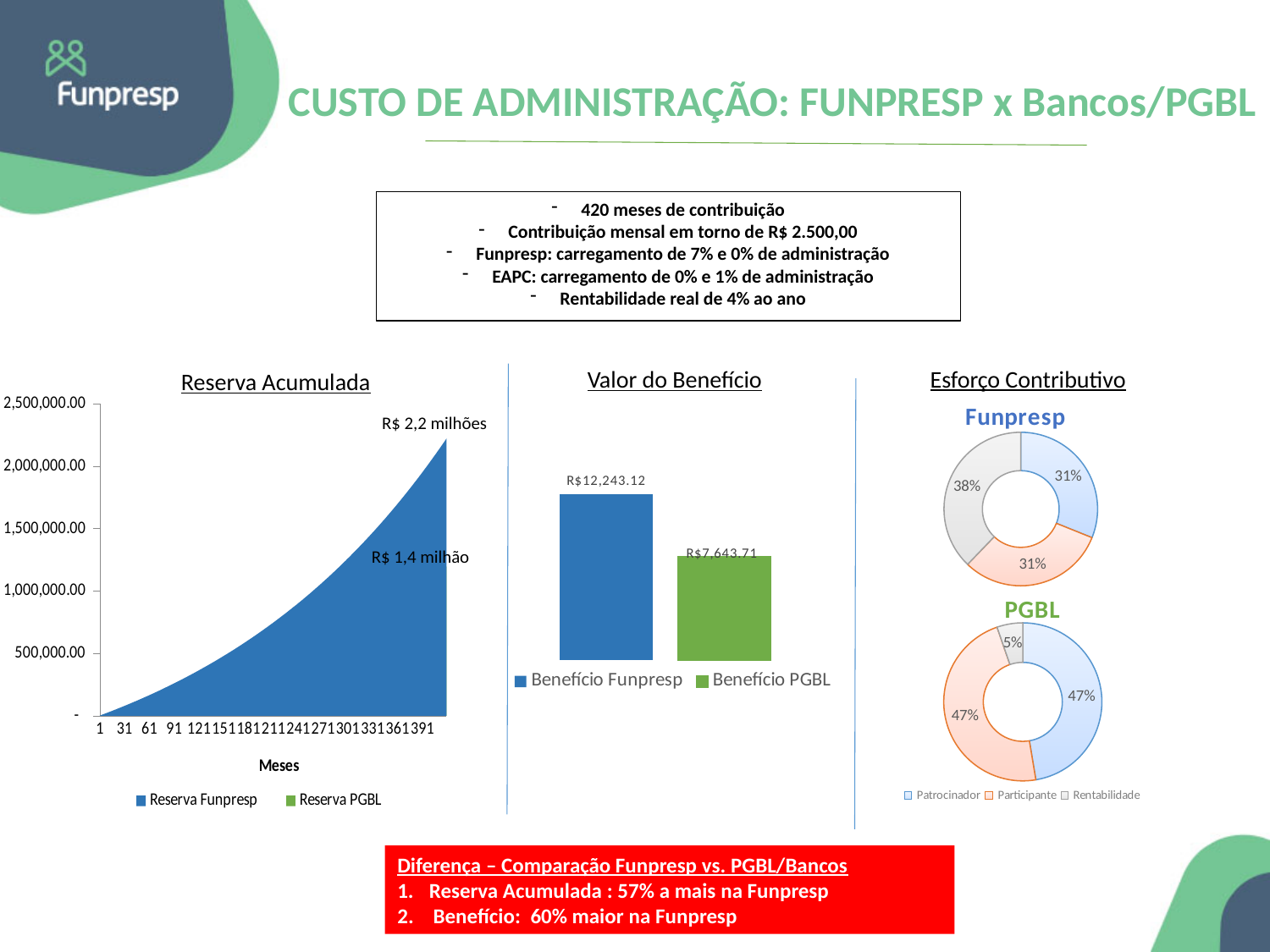
In the 'Valor do Benefício' chart, what is the value for Benefício Funpresp? R$12,243.12 In the 'Esforço Contributivo' Funpresp donut chart, what share is Rentabilidade? 38% In the 'Reserva Acumulada' chart, what final value is labelled for the Reserva Funpresp series? R$ 2,2 milhões In the 'Valor do Benefício' chart, what is the value for Benefício PGBL? R$7,643.71 In the 'Reserva Acumulada' chart, do the values rise or fall as the months increase? Rise In the 'Valor do Benefício' chart, which series has the higher value? Benefício Funpresp In the 'Reserva Acumulada' chart, what final value is labelled for the Reserva PGBL series? R$ 1,4 milhão In the 'Esforço Contributivo' PGBL donut chart, which category has the smallest share? Rentabilidade In the 'Esforço Contributivo' PGBL donut chart, what share is Patrocinador? 47% How many series does the legend of the 'Reserva Acumulada' chart list? 2 What kind of chart is the 'Valor do Benefício' chart? Bar chart In the 'Valor do Benefício' chart, what is the difference between Benefício Funpresp and Benefício PGBL? R$4,599.41